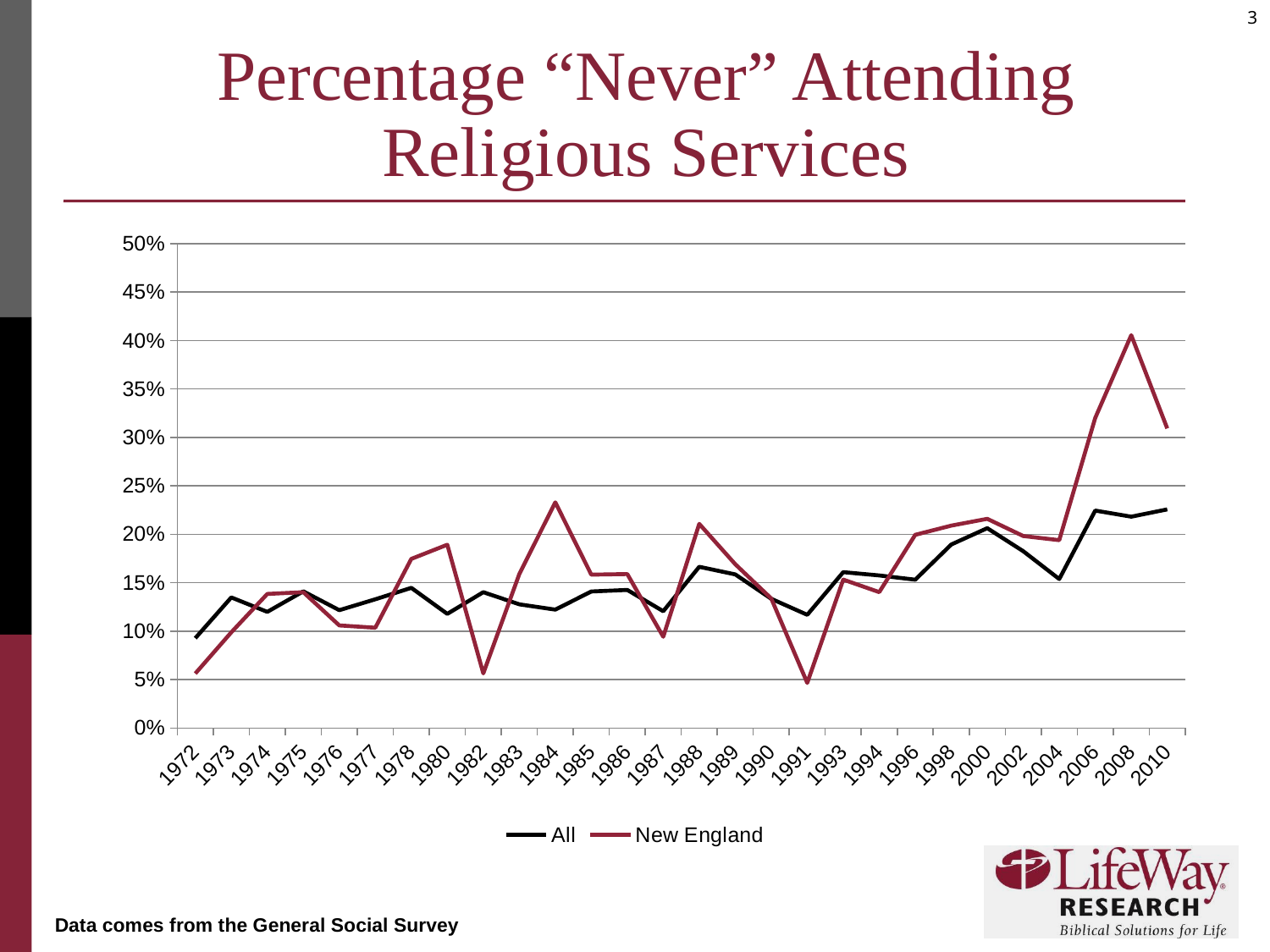
Is the value for All in 1972 greater or less than 10%? less Which series is drawn in black? All In 2008, which series has the higher value, All or New England? New England Is the value for All in 2010 greater or less than 20%? greater In which year does the New England series reach its lowest value? 1991 Is the value for New England in 2008 greater or less than 35%? greater How many series does the legend list? 2 How many years are plotted along the x axis? 28 In which year does the New England series reach its highest value? 2008 Overall, does the All series rise or fall from 1972 to 2010? rise What kind of chart is shown on the slide? line chart